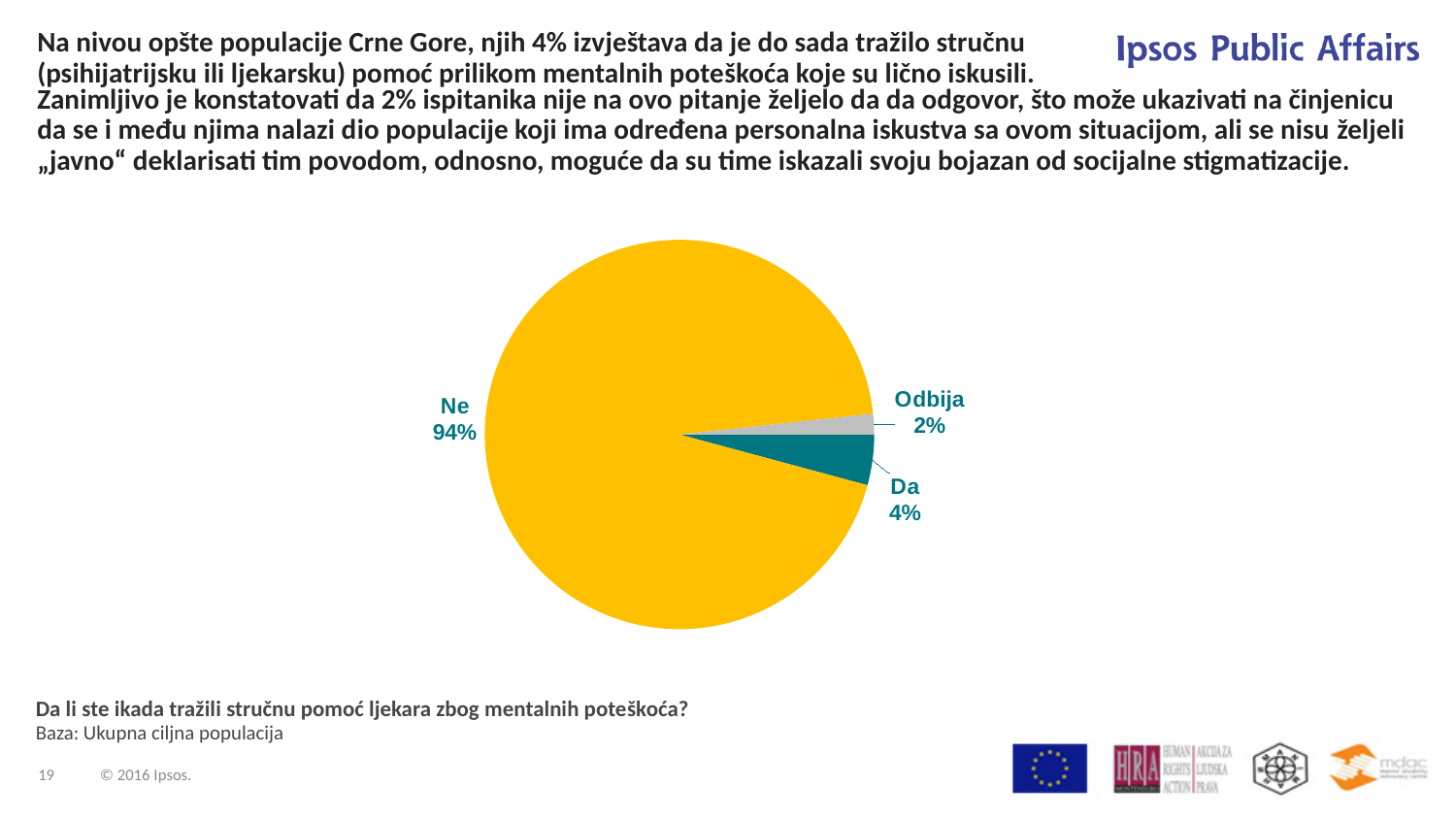
What is the difference in percentage points between the "Ne" slice and the "Da" slice? 90 Which slice of the pie is the smallest? Odbija What question is the pie chart based on, as stated below the chart? Da li ste ikada tražili stručnu pomoć ljekara zbog mentalnih poteškoća? Which slice of the pie is the largest? Ne How many slices does the pie chart have? 3 Which is larger, the "Da" slice or the "Odbija" slice? Da What share of the pie does the "Ne" slice represent? 94% What kind of chart is shown on the slide? pie chart What colour is the "Ne" slice of the pie? yellow What is the difference in percentage points between the "Da" slice and the "Odbija" slice? 2 What share of the pie does the "Odbija" slice represent? 2% What share of the pie does the "Da" slice represent? 4%